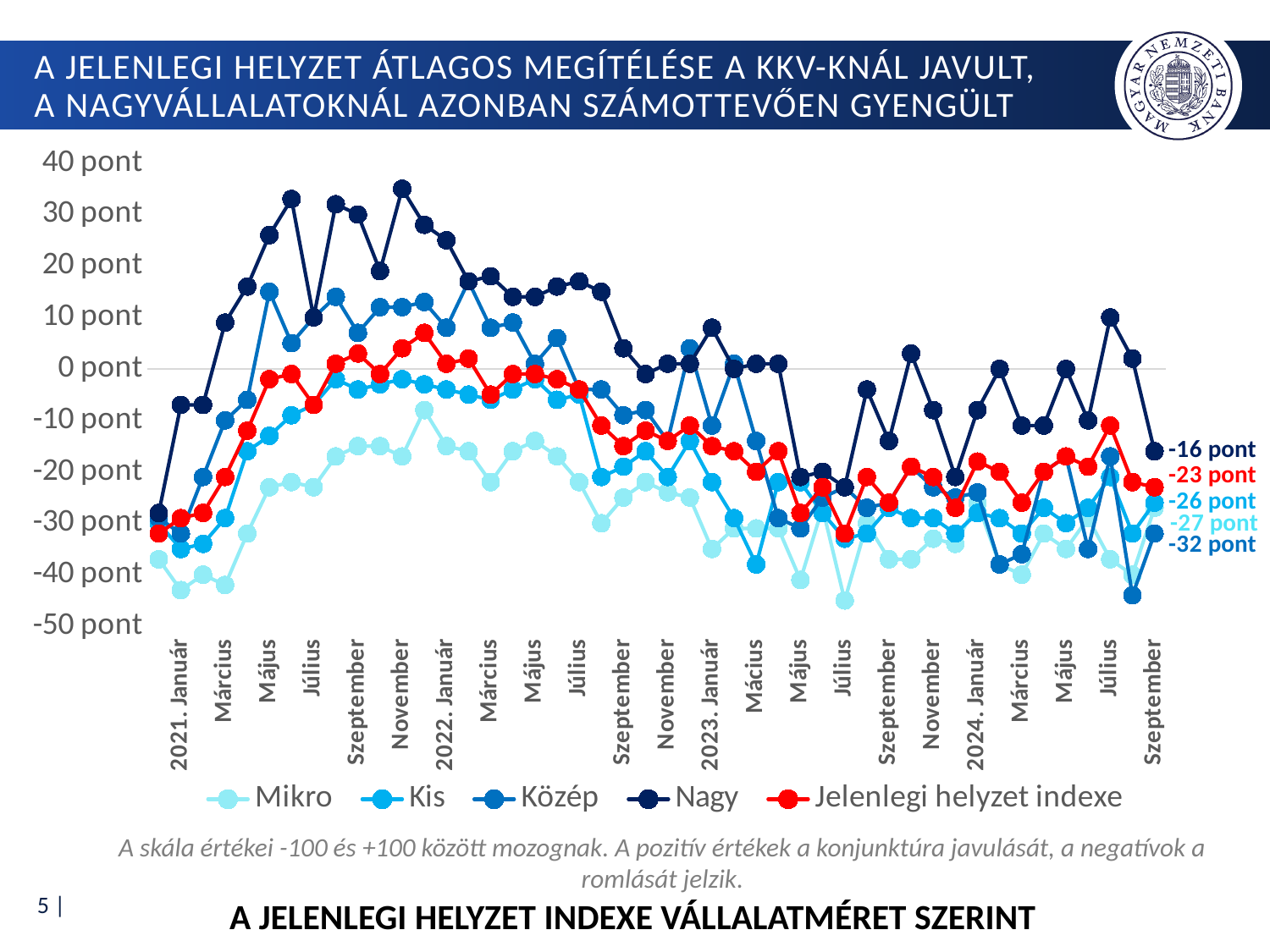
Is the value for the Nagy series in November 2021 greater or less than 30 pont? greater What is the value labelled for the Jelenlegi helyzet indexe series at the end of the chart (2024 September)? -23 pont What kind of chart is shown on the slide? line chart Is the value for the Mikro series in 2021 January greater or less than -30 pont? less At the end of the chart, which is higher: the Nagy series or the Jelenlegi helyzet indexe series? Nagy What is the value labelled for the Nagy series at the end of the chart (2024 September)? -16 pont Does the Nagy series rise or fall between 2021 January and 2021 May? rise What is the first entry in the chart legend? Mikro Which series has the highest value at the last data point (2024 September)? Nagy What is the lowest value among the labels printed at the right end of the chart? -32 pont How many series does the legend list? 5 What is the difference between the end-of-chart values of Nagy (-16 pont) and Jelenlegi helyzet indexe (-23 pont)? 7 pont